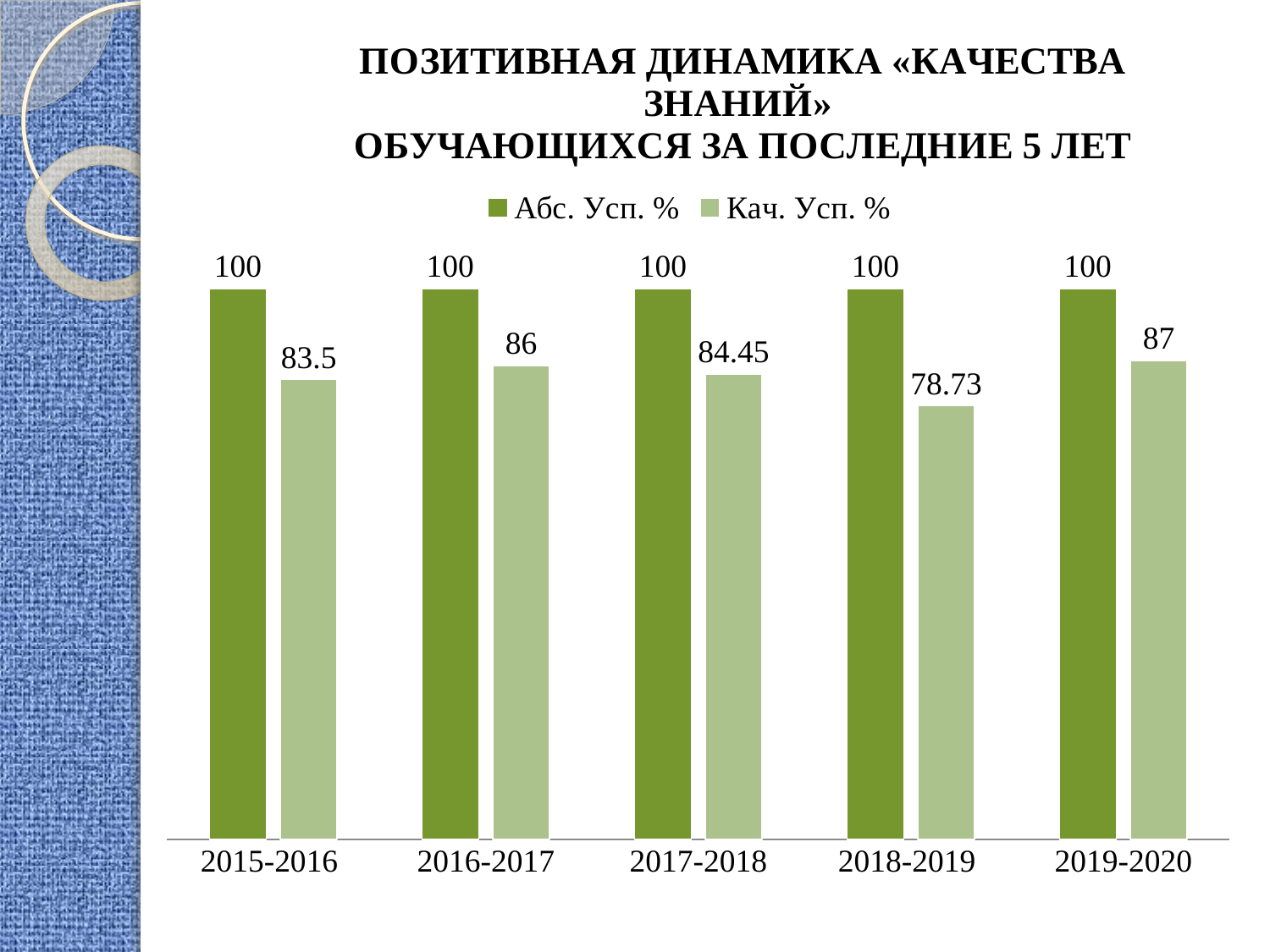
What is the value of Кач. Усп. % for 2019-2020? 87 What is the value of Кач. Усп. % for 2018-2019? 78.73 How many series does the legend list? 2 What is the value of Кач. Усп. % for 2015-2016? 83.5 What is the difference between Кач. Усп. % in 2019-2020 and 2018-2019? 8.27 Which year has the highest Кач. Усп. % value? 2019-2020 What is the value of Абс. Усп. % for 2017-2018? 100 What kind of chart is shown on the slide? Bar chart What are the two series named in the legend? Абс. Усп. % and Кач. Усп. % Which is larger: Кач. Усп. % in 2016-2017 or in 2017-2018? 2016-2017 How many year categories are shown on the x axis? 5 Which year has the lowest Кач. Усп. % value? 2018-2019